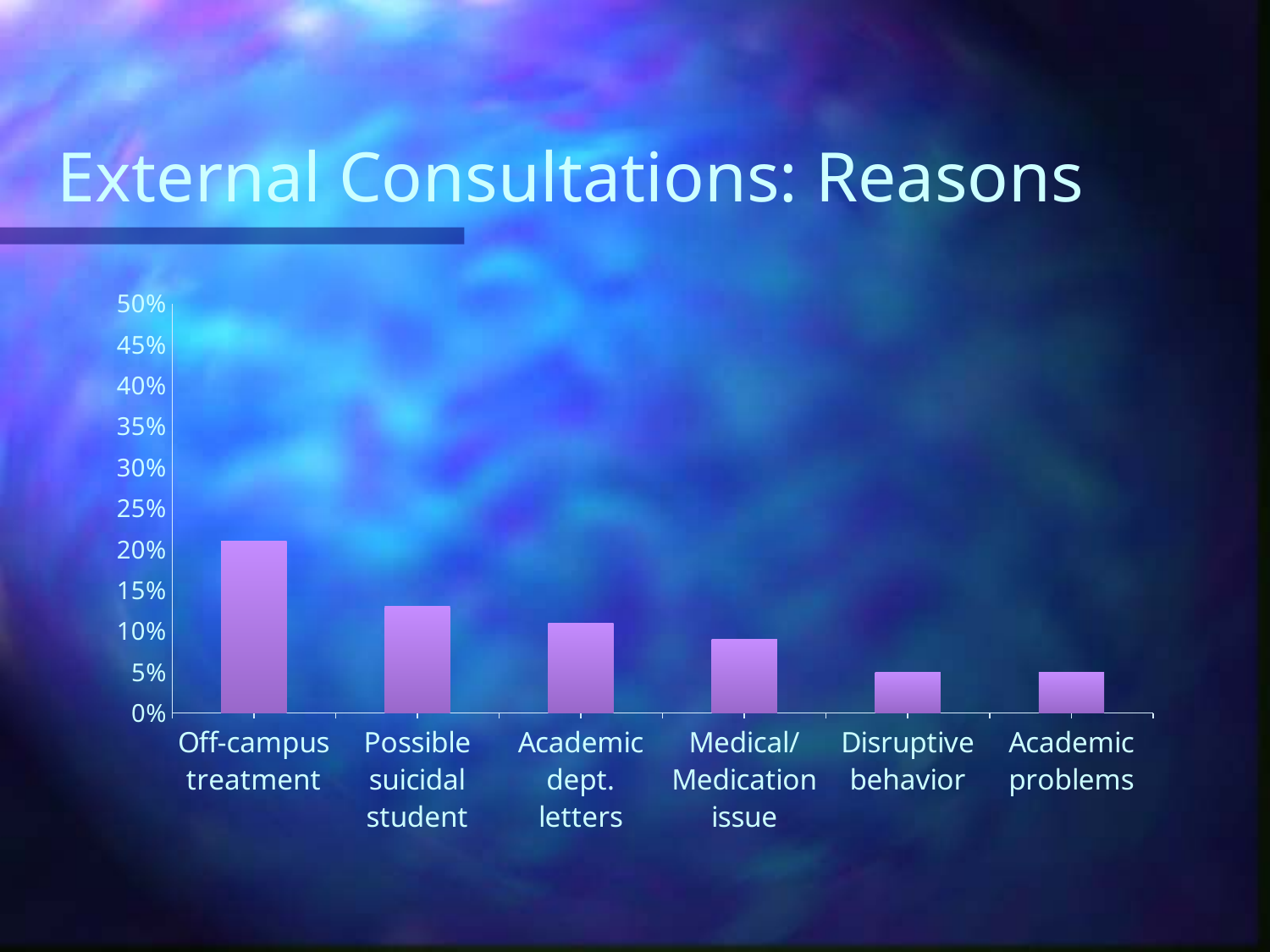
Is the value for Off-campus treatment greater or less than 15%? greater Which is larger, the value for Academic dept. letters or the value for Medical/Medication issue? Academic dept. letters Is the value for Academic dept. letters greater or less than 15%? less What is the title of the slide? External Consultations: Reasons Do the bar values generally rise or fall from left to right across the categories? Fall Is the value for Academic problems greater or less than 10%? less Which reason has the highest percentage in the chart? Off-campus treatment How many reason categories are plotted in the chart? 6 What kind of chart is shown on the slide? Bar chart Which is larger, the value for Off-campus treatment or the value for Possible suicidal student? Off-campus treatment